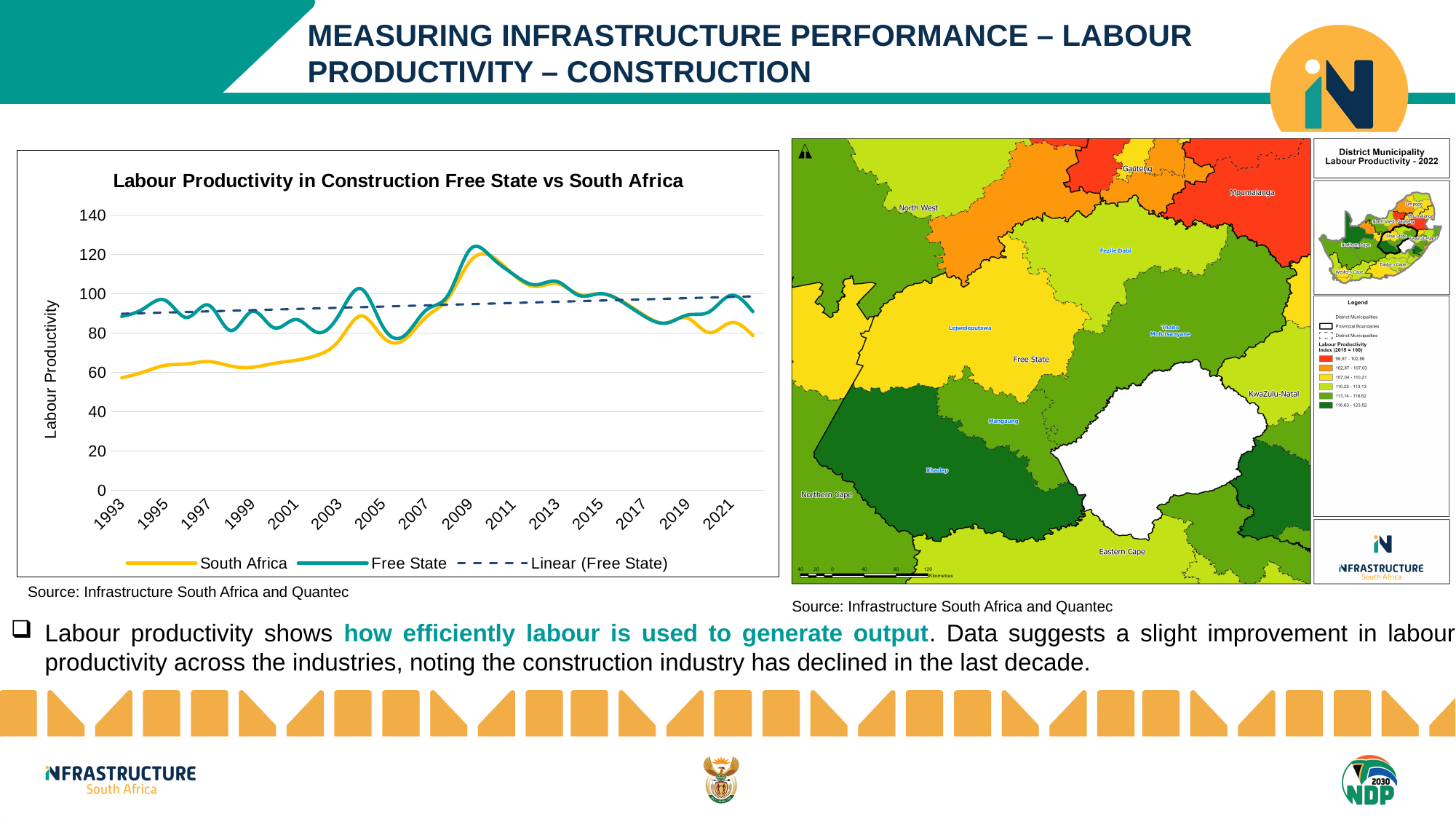
In the line chart, which series has the higher value in 2001, South Africa or Free State? Free State In the line chart, which series has the higher value in 1993, South Africa or Free State? Free State What is the title of the line chart on the left of the slide? Labour Productivity in Construction Free State vs South Africa What is the label on the vertical axis of the line chart? Labour Productivity In the line chart, is the value for Free State in 1993 greater or less than 80? greater In the line chart, is the value for South Africa in 2009 greater or less than 100? greater In the line chart, does the South Africa series generally rise or fall between 1993 and 2009? Rise In the line chart, is the value for South Africa in 2021 greater or less than 100? less How many year labels are shown on the x axis of the line chart? 15 What kind of chart is 'Labour Productivity in Construction Free State vs South Africa'? Line chart How many entries does the legend of the line chart list? 3